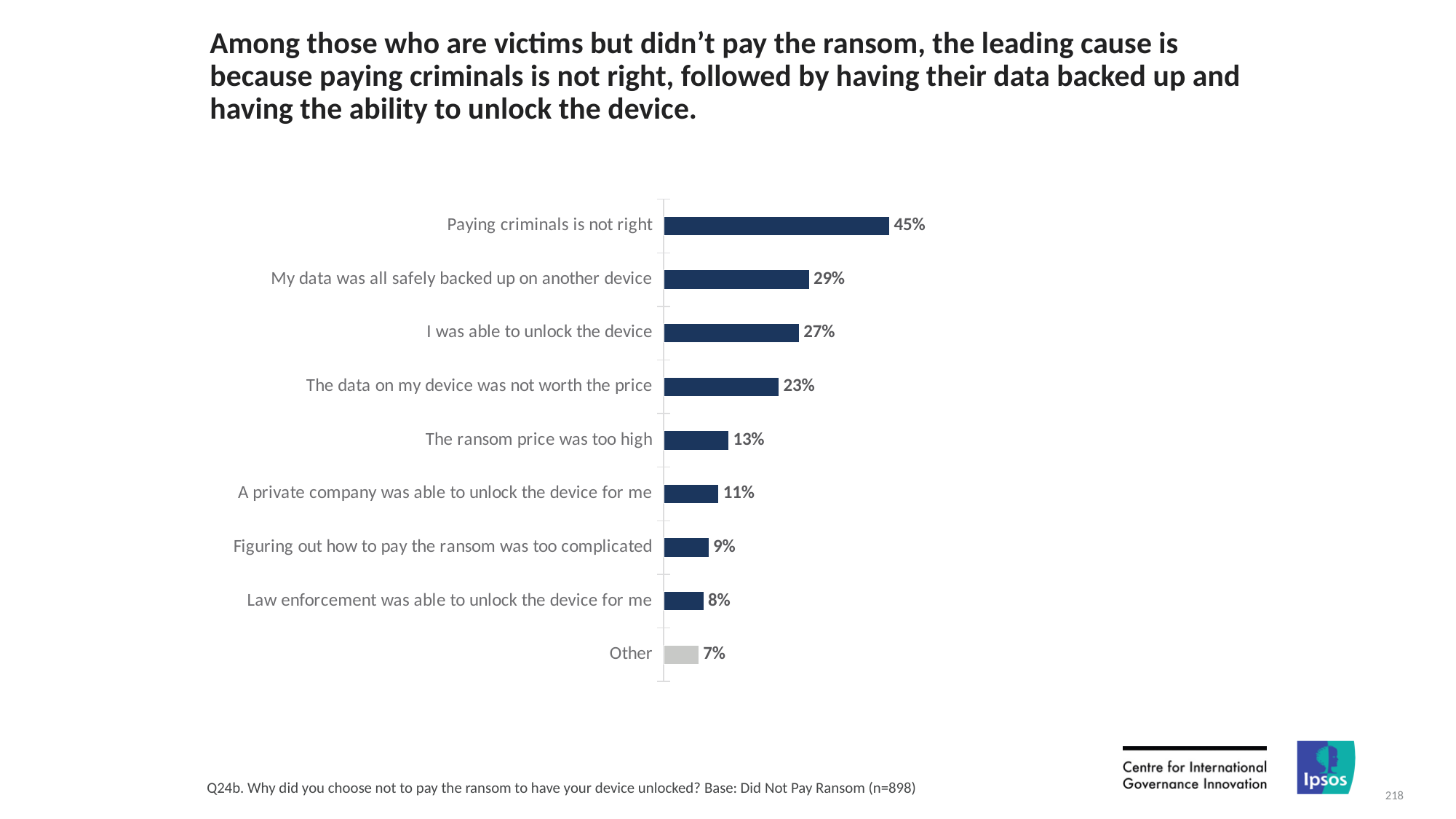
What percentage of respondents said 'Paying criminals is not right'? 45% Which is larger: 'A private company was able to unlock the device for me' or 'Figuring out how to pay the ransom was too complicated'? A private company was able to unlock the device for me What type of chart is shown on the slide? Bar chart Which category has the lowest percentage? Other What is the value for 'Law enforcement was able to unlock the device for me'? 8% What is the difference between 'Paying criminals is not right' and 'I was able to unlock the device'? 18% What is the value for 'My data was all safely backed up on another device'? 29% What percentage chose 'The ransom price was too high'? 13% Which bar is shown in a different colour (grey) from the others? Other How many categories are shown in the chart? 9 Which reason has the highest percentage? Paying criminals is not right What is the difference between 'The data on my device was not worth the price' and 'The ransom price was too high'? 10%